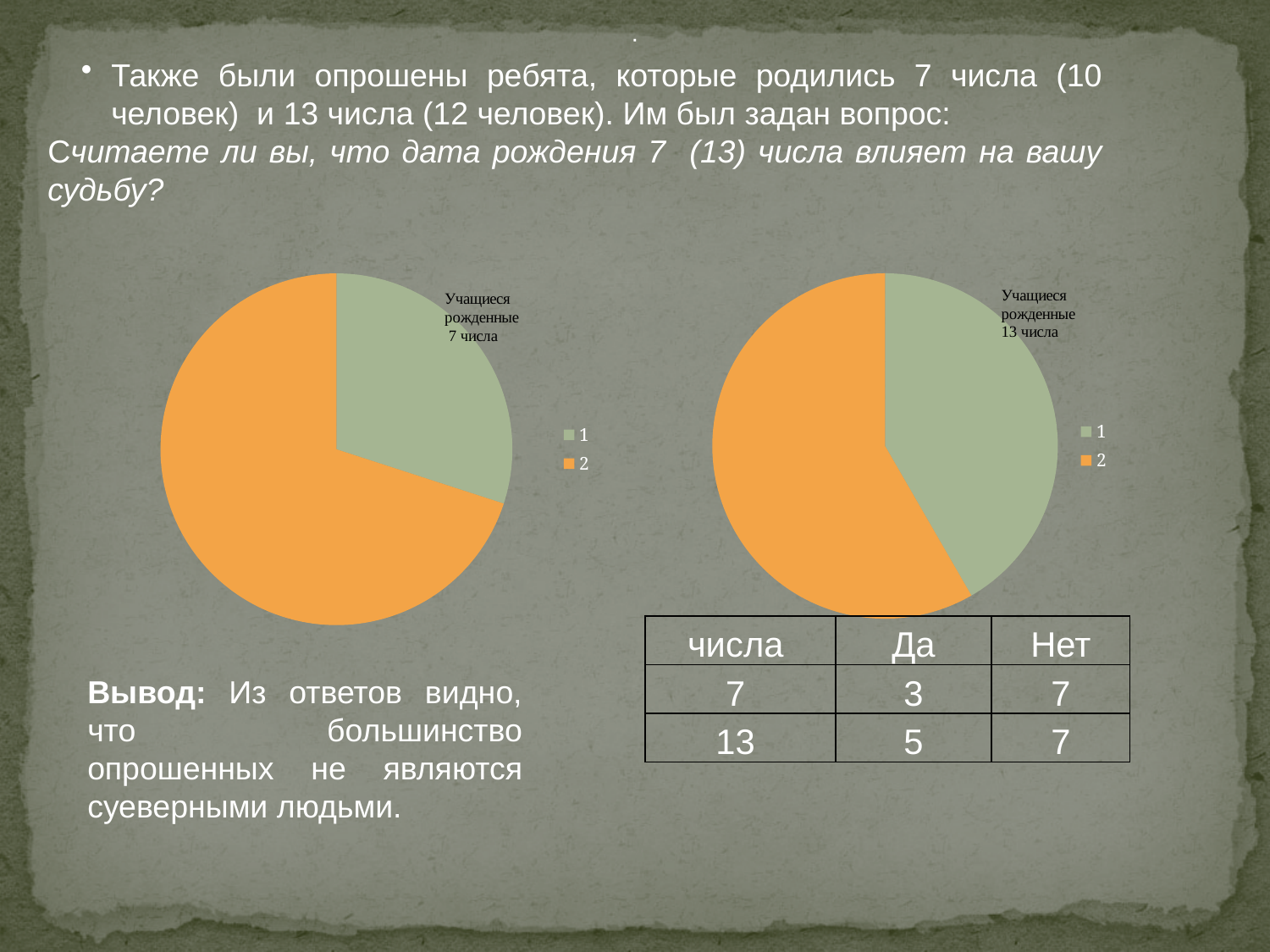
What kind of chart is the left chart titled "Учащиеся рожденные 7 числа"? pie chart How many slices does the right pie chart "Учащиеся рожденные 13 числа" have? 2 In the right pie chart "Учащиеся рожденные 13 числа", which category has the largest slice? 2 In the left pie chart "Учащиеся рожденные 7 числа", which slice is larger, category 1 or category 2? 2 How many entries does the legend of the left pie chart "Учащиеся рожденные 7 числа" list? 2 In the left pie chart "Учащиеся рожденные 7 числа", which category has the smallest slice? 1 What kind of chart is the right chart titled "Учащиеся рожденные 13 числа"? pie chart In the right pie chart "Учащиеся рожденные 13 числа", which category has the smallest slice? 1 How many slices does the left pie chart "Учащиеся рожденные 7 числа" have? 2 What are the legend entries of the right pie chart "Учащиеся рожденные 13 числа"? 1, 2 In the left pie chart "Учащиеся рожденные 7 числа", what colour is the slice for category 2? orange In the left pie chart "Учащиеся рожденные 7 числа", which category has the largest slice? 2